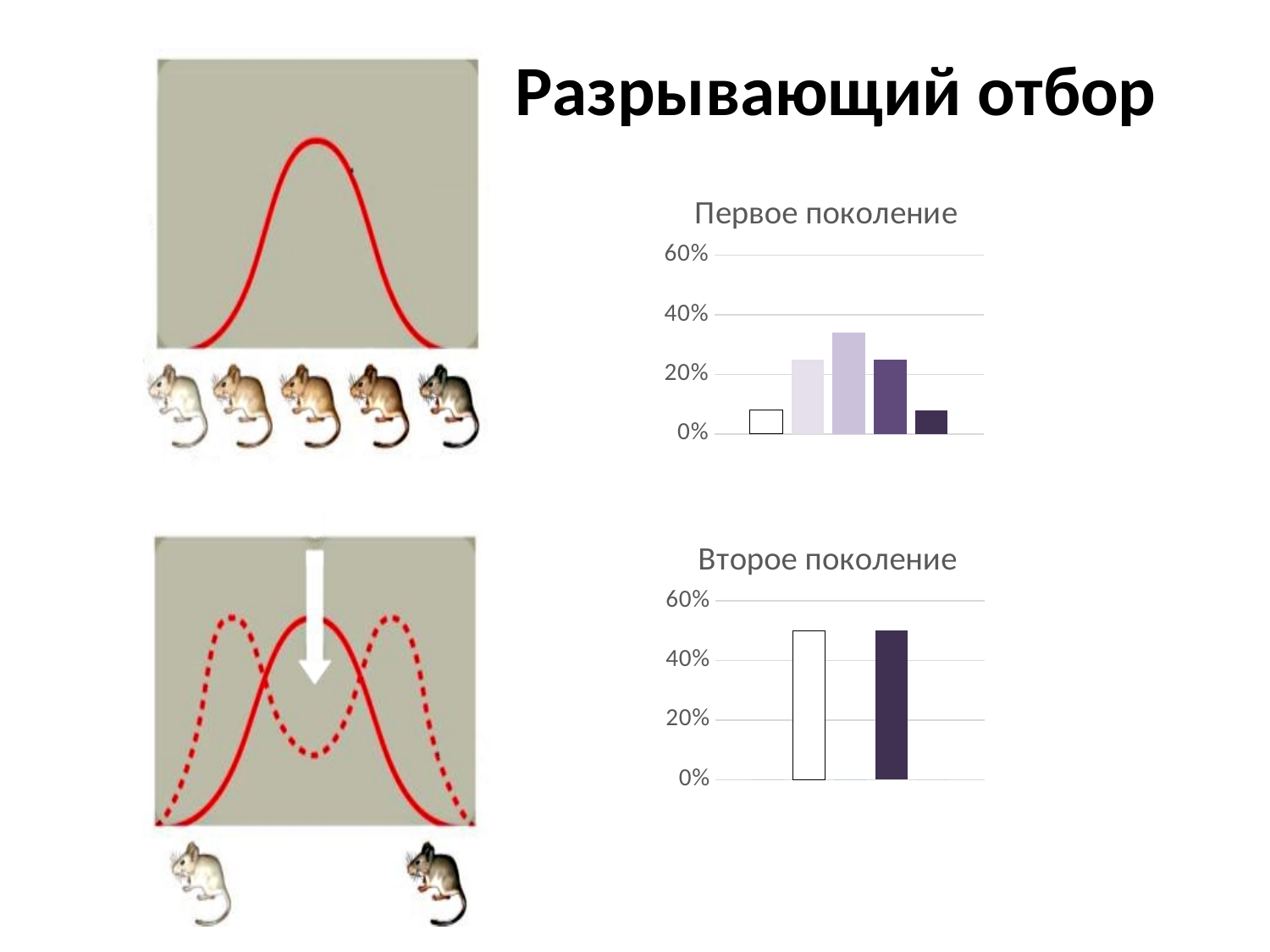
In the 'Второе поколение' chart, is the value of the right bar greater or less than 60%? less How many bars are plotted in the 'Второе поколение' chart? 2 In the 'Первое поколение' chart, is the value of the first (leftmost) bar greater or less than 20%? less In the 'Первое поколение' chart, is the value of the middle bar greater or less than 20%? greater What is the title of the upper chart on the slide? Первое поколение What kind of chart is the 'Первое поколение' chart? bar chart In the 'Первое поколение' chart, which is larger: the middle bar or the leftmost bar? the middle bar What is the title of the lower chart on the slide? Второе поколение In the 'Первое поколение' chart, which bar is the highest? the middle (third) bar How many bars are plotted in the 'Первое поколение' chart? 5